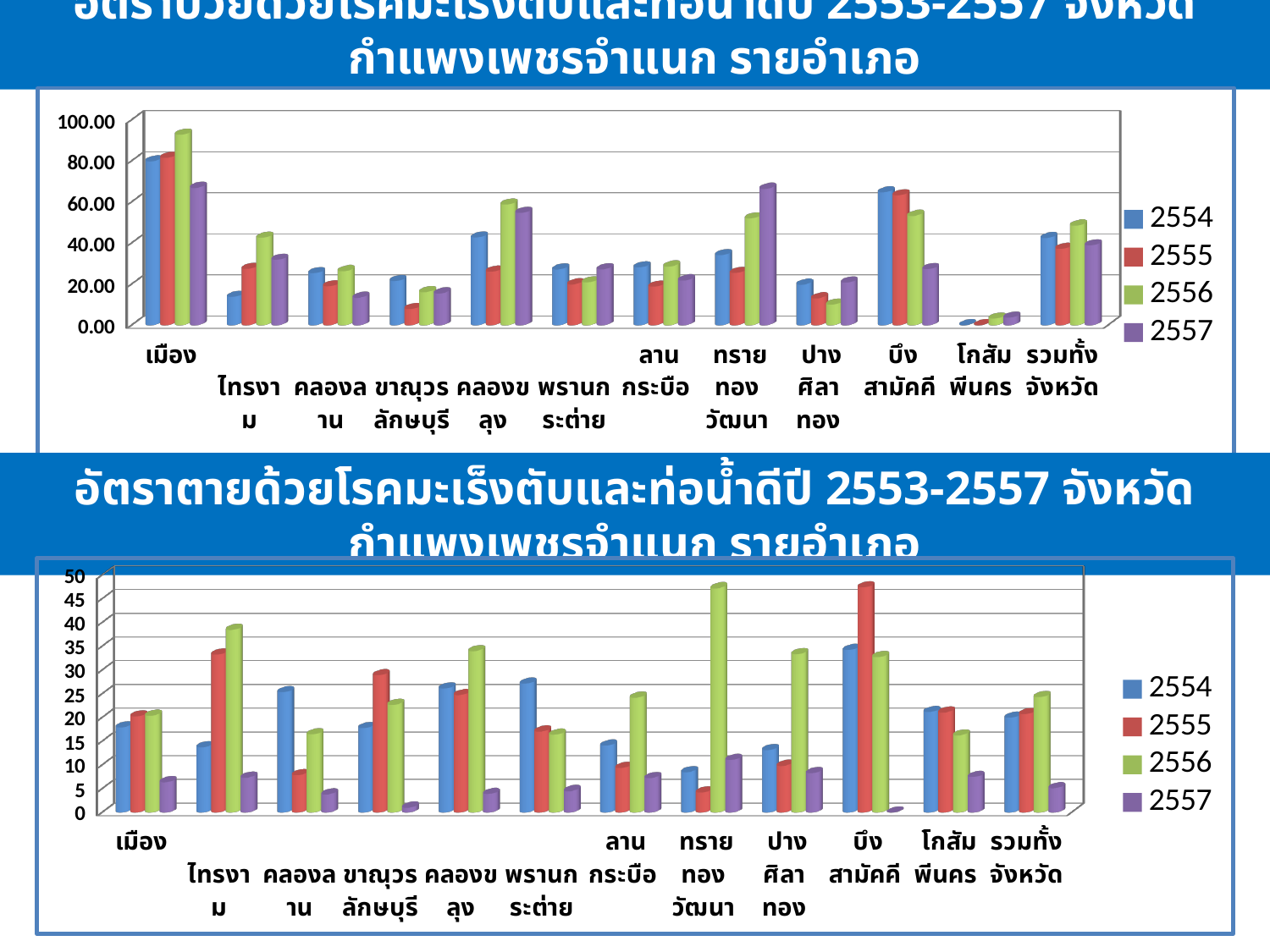
What are the legend entries of the bottom chart (อัตราตาย)? 2554, 2555, 2556, 2557 In the bottom chart (อัตราตาย), is the value for บึงสามัคคี in 2555 greater or less than 40? greater In the top chart, is the value for เมือง in 2554 greater or less than 60.00? greater In the top chart, which category and series has the highest bar? เมือง, 2556 In the bottom chart (อัตราตาย), how many districts/categories are shown on the x axis? 12 In the bottom chart (อัตราตาย), is the value for ขาณุวรลักษบุรี in 2557 greater or less than 5? less What kind of chart is the bottom chart (อัตราตาย)? Bar chart In the bottom chart (อัตราตาย), which is larger: เมือง in 2554 or ไทรงาม in 2555? ไทรงาม in 2555 In the top chart, which category has the lowest bars overall? โกสัมพีนคร In the top chart, how many series does the legend list? 4 In the top chart, which is larger: บึงสามัคคี in 2554 or ปางศิลาทอง in 2554? บึงสามัคคี in 2554